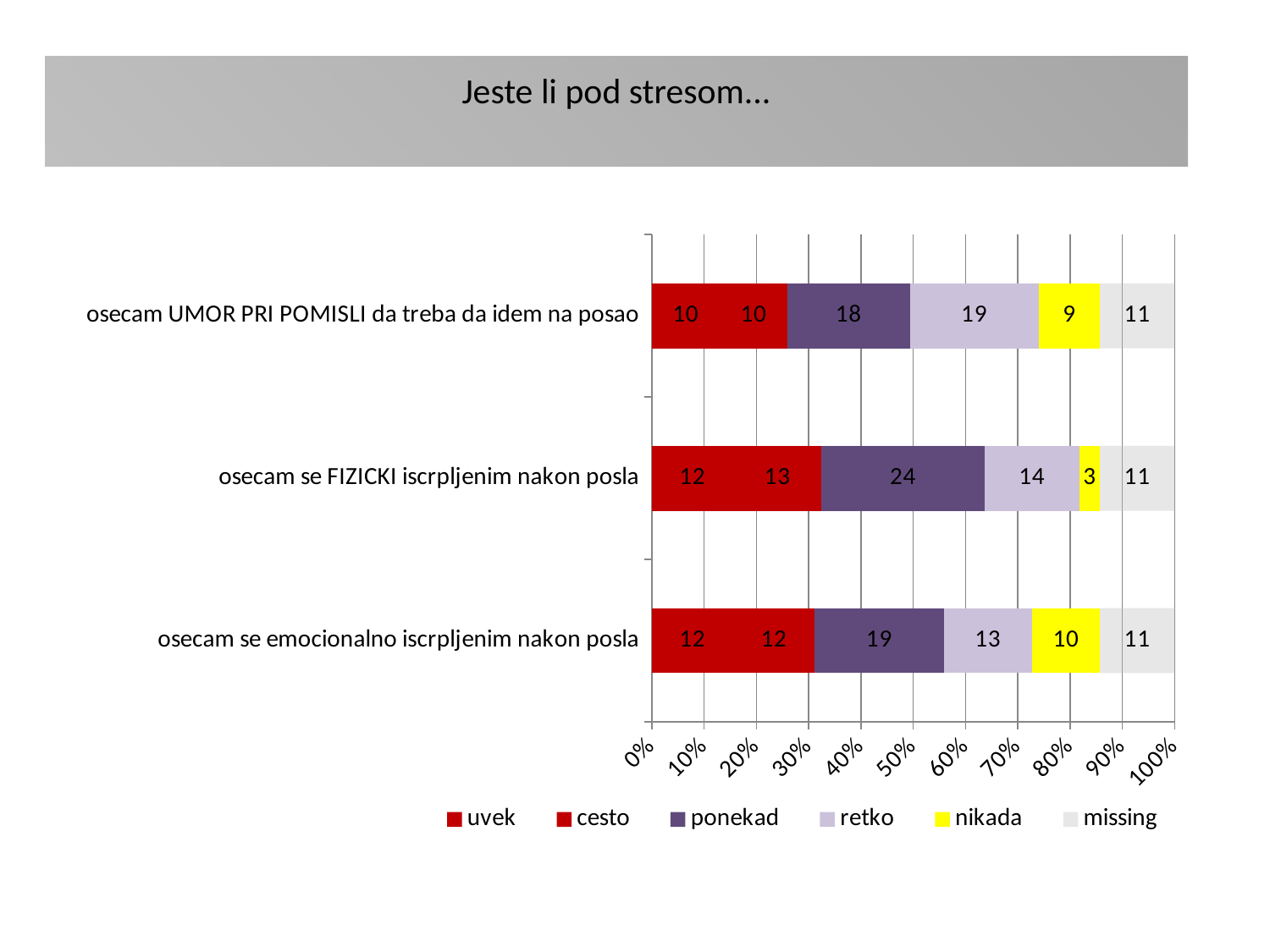
Which category has the larger 'retko' value: 'osecam UMOR PRI POMISLI da treba da idem na posao' or 'osecam se FIZICKI iscrpljenim nakon posla'? osecam UMOR PRI POMISLI da treba da idem na posao Which category has the lowest 'nikada' value? osecam se FIZICKI iscrpljenim nakon posla Which category has the highest 'ponekad' value? osecam se FIZICKI iscrpljenim nakon posla How many categories are shown on the chart? 3 What is the difference between the 'ponekad' values for 'osecam se FIZICKI iscrpljenim nakon posla' and 'osecam UMOR PRI POMISLI da treba da idem na posao'? 6 How many series does the legend list? 6 What colour represents the 'nikada' series in the chart? Yellow What is the title of the slide? Jeste li pod stresom… What is the value of 'nikada' for 'osecam UMOR PRI POMISLI da treba da idem na posao'? 9 What kind of chart is shown on the slide? Stacked bar chart What is the value of 'ponekad' for 'osecam se FIZICKI iscrpljenim nakon posla'? 24 What is the value of 'retko' for 'osecam se emocionalno iscrpljenim nakon posla'? 13